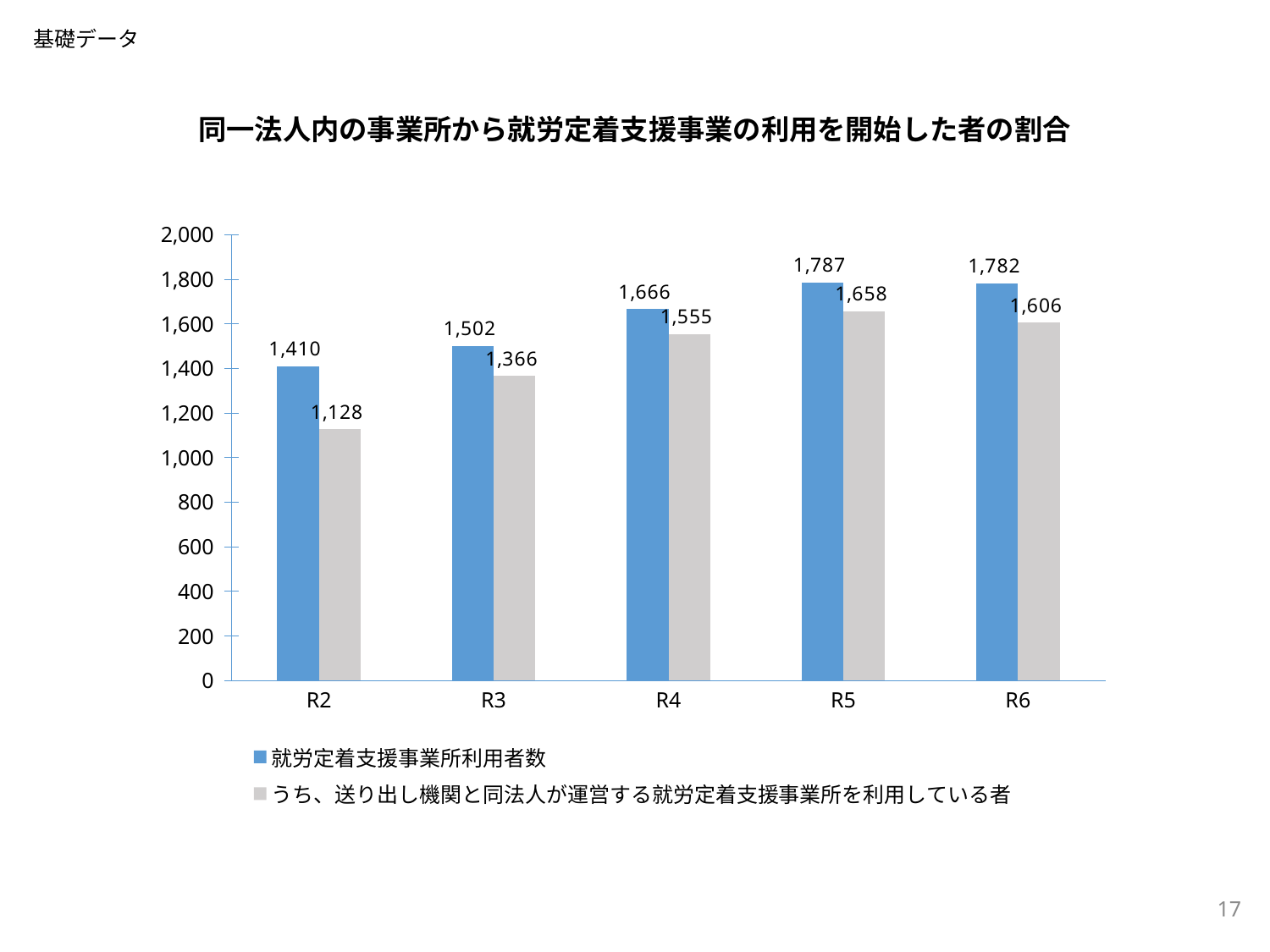
Is the value of 就労定着支援事業所利用者数 for R3 greater or less than 1,400? greater What is the value of 就労定着支援事業所利用者数 for R6? 1,782 How many series does the legend list? 2 What is the value of うち、送り出し機関と同法人が運営する就労定着支援事業所を利用している者 for R2? 1,128 What kind of chart is shown on the slide? Bar chart Which year has the highest value for 就労定着支援事業所利用者数? R5 What is the difference between 就労定着支援事業所利用者数 and うち、送り出し機関と同法人が運営する就労定着支援事業所を利用している者 for R3? 136 What is the difference in 就労定着支援事業所利用者数 between R2 and R5? 377 How many years are shown on the x axis? 5 Which year has the lowest value for うち、送り出し機関と同法人が運営する就労定着支援事業所を利用している者? R2 Which is larger: うち、送り出し機関と同法人が運営する就労定着支援事業所を利用している者 for R5 or for R6? R5 What is the value of 就労定着支援事業所利用者数 for R4? 1,666